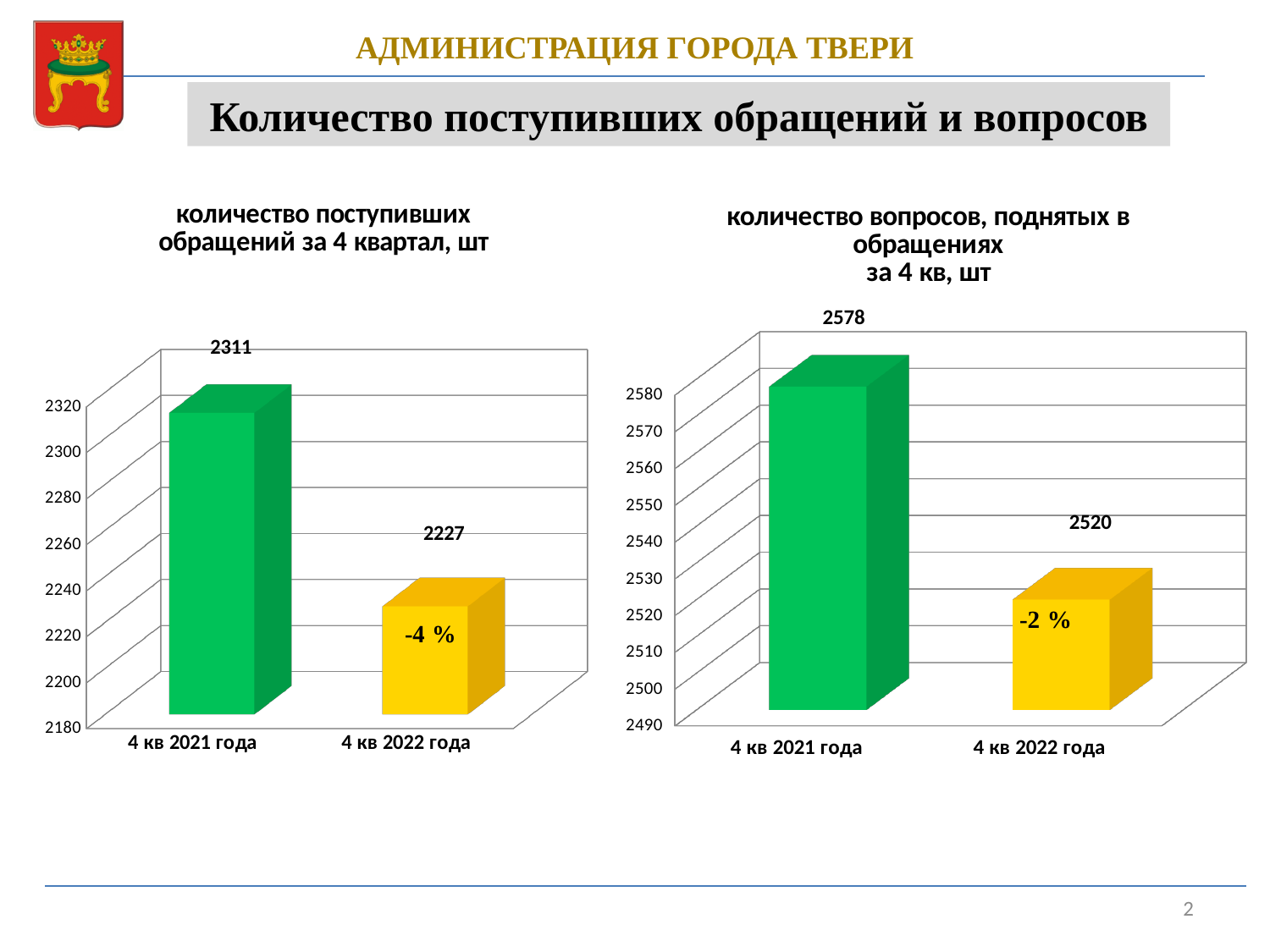
In the left chart, which category has the higher value? 4 кв 2021 года What kind of chart is the left chart? bar chart In the left chart, what is the difference between the values for 4 кв 2021 года and 4 кв 2022 года? 84 In the left chart, what percentage change is printed on the bar for 4 кв 2022 года? -4 % How many categories are shown in the right chart? 2 In the right chart (количество вопросов, поднятых в обращениях за 4 кв, шт), what is the value for 4 кв 2021 года? 2578 In the left chart, do the values rise or fall from 4 кв 2021 года to 4 кв 2022 года? fall In the right chart (количество вопросов, поднятых в обращениях за 4 кв, шт), what is the value for 4 кв 2022 года? 2520 In the right chart, what is the difference between the values for 4 кв 2021 года and 4 кв 2022 года? 58 In the right chart, which category has the lower value? 4 кв 2022 года In the left chart (количество поступивших обращений за 4 квартал, шт), what is the value for 4 кв 2021 года? 2311 In the left chart (количество поступивших обращений за 4 квартал, шт), what is the value for 4 кв 2022 года? 2227